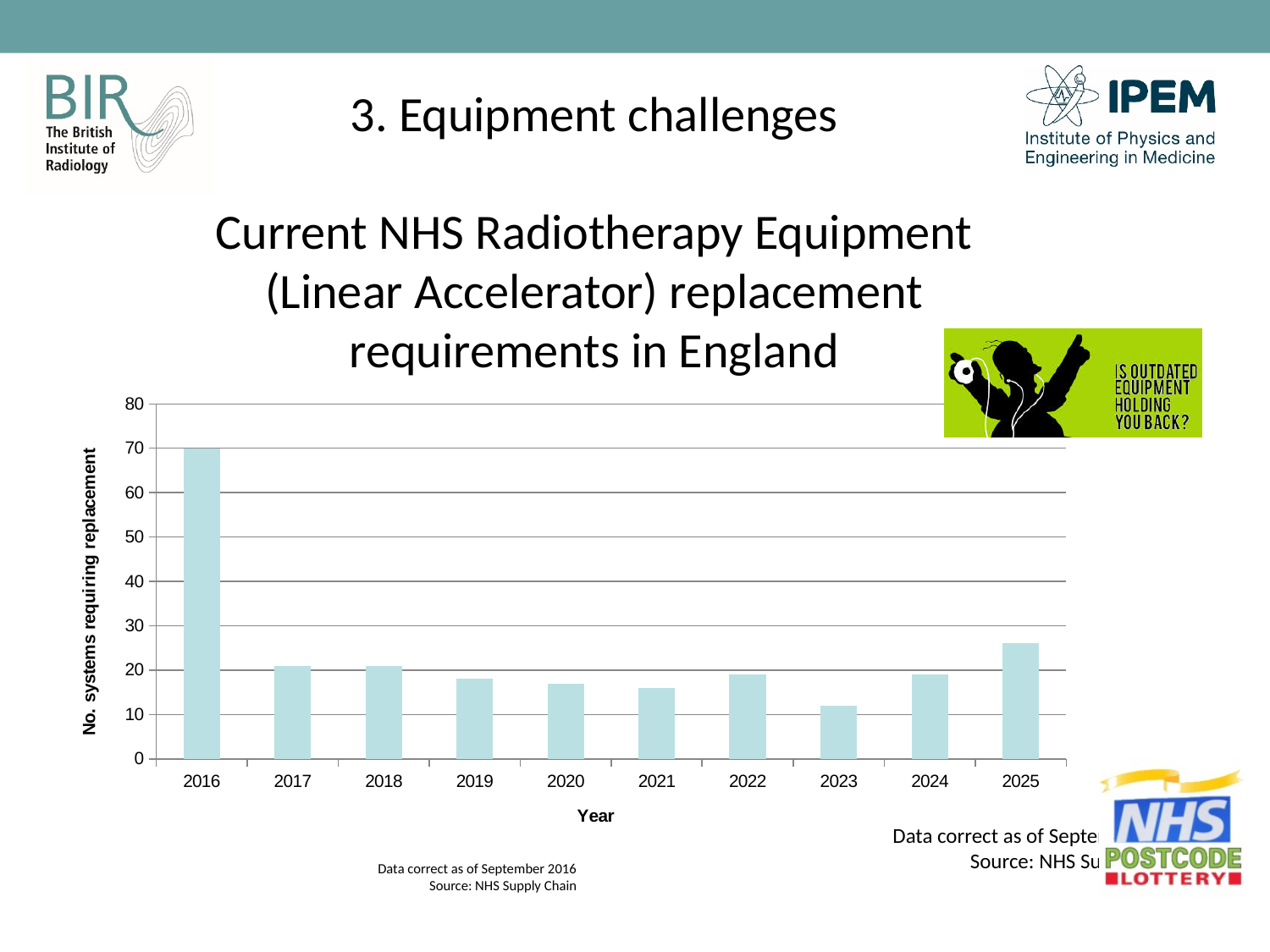
Is the value for 2021 greater or less than 20? less What is the number of systems requiring replacement in 2016? 70 What kind of chart is shown on the slide? bar chart Is the value for 2025 greater or less than 20? greater How many years are shown on the x axis of the chart? 10 Which year has the larger value, 2016 or 2025? 2016 Is the value for 2023 greater or less than 20? less Which year has the lowest number of systems requiring replacement? 2023 Which year has the highest number of systems requiring replacement? 2016 Which year has the larger value, 2023 or 2025? 2025 What is the label on the y axis of the chart? No. systems requiring replacement What is the label on the x axis of the chart? Year